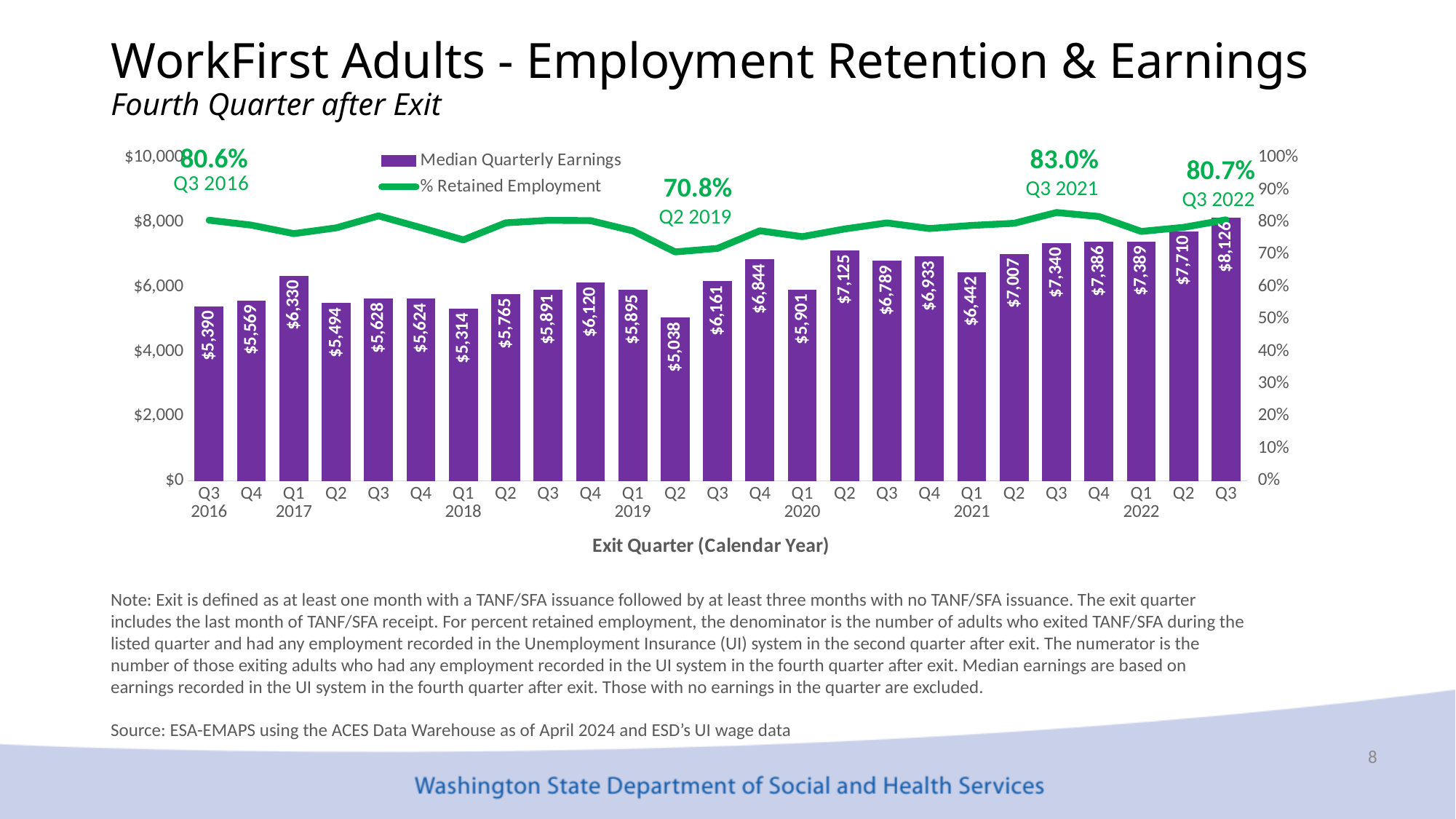
Which exit quarter has the lowest median quarterly earnings? Q2 2019 What is the median quarterly earnings value for Q3 2022? $8,126 What is the difference in median quarterly earnings between Q3 2022 and Q3 2016? $2,736 How many exit quarters are shown on the x axis? 25 What is the x-axis title of the chart? Exit Quarter (Calendar Year) Which exit quarter has the highest median quarterly earnings? Q3 2022 How many series does the legend list? 2 What is the % retained employment value labeled for Q3 2021? 83.0% What is the % retained employment value labeled for Q2 2019? 70.8% Which has higher median quarterly earnings, Q1 2017 or Q2 2017? Q1 2017 Is the % retained employment for Q2 2019 greater or less than 80%? less What is the median quarterly earnings value for Q2 2019? $5,038